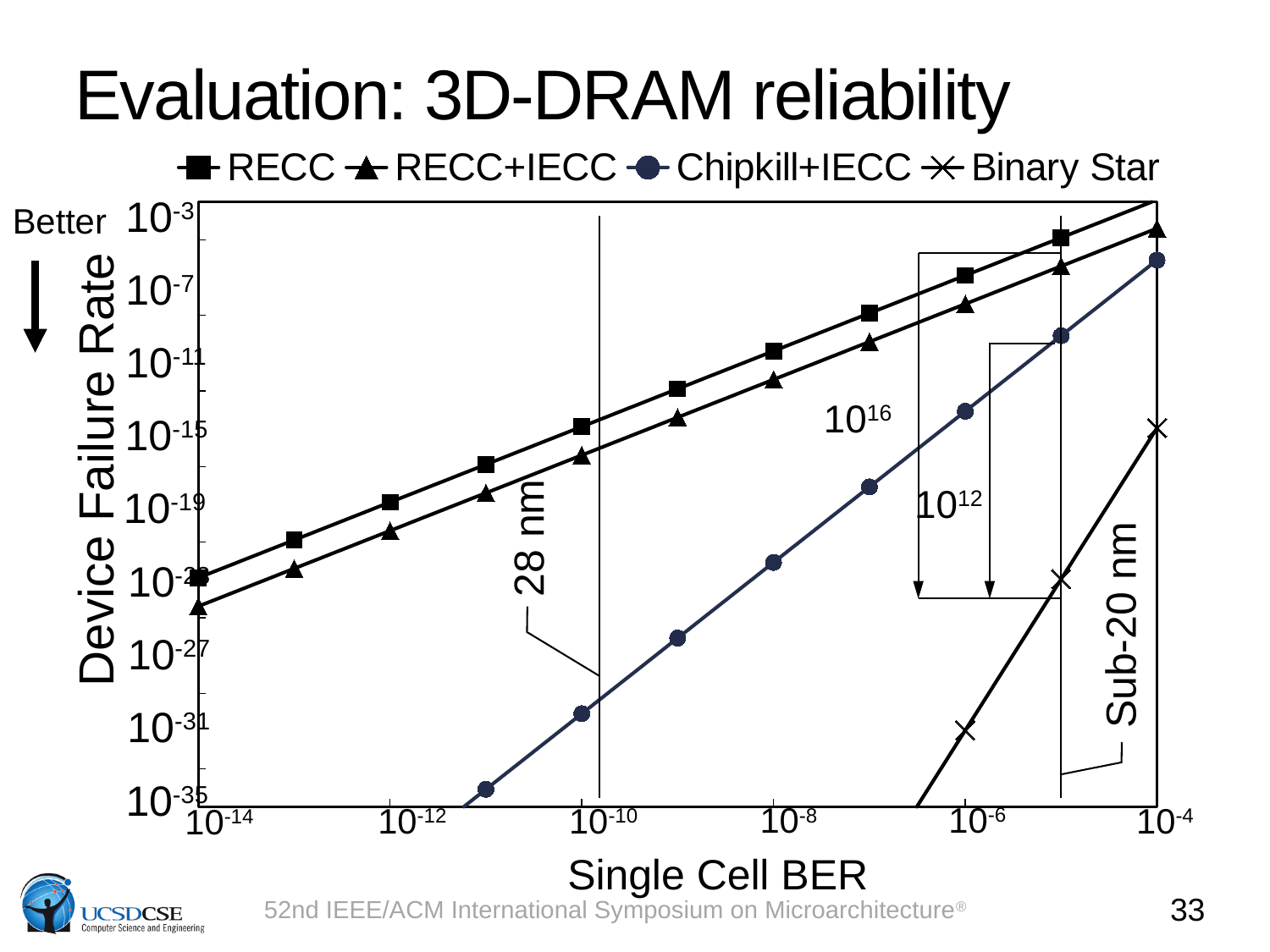
At a single cell BER of 10^-10, which series has the higher device failure rate, RECC or Chipkill+IECC? RECC What is the label of the x axis? Single Cell BER What technology node is marked by the vertical line at a single cell BER of 10^-10? 28 nm Is the device failure rate for RECC+IECC at a single cell BER of 10^-14 greater or less than 10^-19? less At a single cell BER of 10^-6, which series has the higher device failure rate, RECC+IECC or Binary Star? RECC+IECC How many series does the legend list? 4 What kind of chart is shown on the slide? line chart Is the device failure rate for Chipkill+IECC at a single cell BER of 10^-10 greater or less than 10^-27? less Which series has the lowest device failure rate across the plotted range? Binary Star Which series has the highest device failure rate across the plotted range? RECC Is the device failure rate for Chipkill+IECC at a single cell BER of 10^-4 greater or less than 10^-11? greater Does the device failure rate rise or fall as the single cell BER increases along the x axis? rise